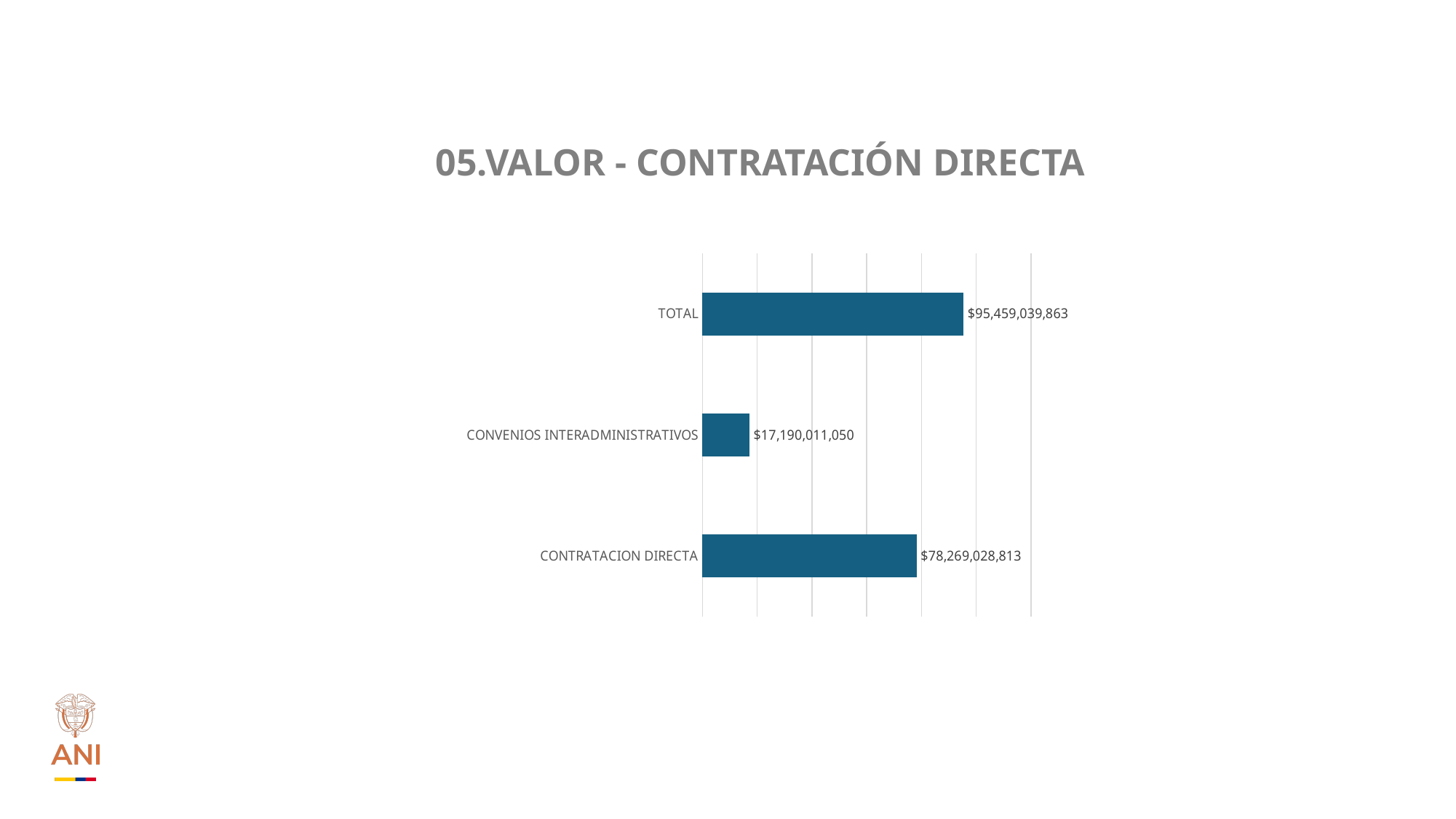
Which category has the highest value? TOTAL What is the difference between the TOTAL value and the CONTRATACION DIRECTA value? $17,190,011,050 What kind of chart is shown on the slide? Bar chart Which is larger, the value for CONTRATACION DIRECTA or the value for CONVENIOS INTERADMINISTRATIVOS? CONTRATACION DIRECTA What is the difference between the CONTRATACION DIRECTA value and the CONVENIOS INTERADMINISTRATIVOS value? $61,079,017,763 How many categories are shown in the chart? 3 Which category has the lowest value? CONVENIOS INTERADMINISTRATIVOS What is the value shown for CONVENIOS INTERADMINISTRATIVOS? $17,190,011,050 What is the title of the slide? 05.VALOR - CONTRATACIÓN DIRECTA What is the value shown for TOTAL? $95,459,039,863 What is the value shown for CONTRATACION DIRECTA? $78,269,028,813 What colour are the bars in the chart? Blue